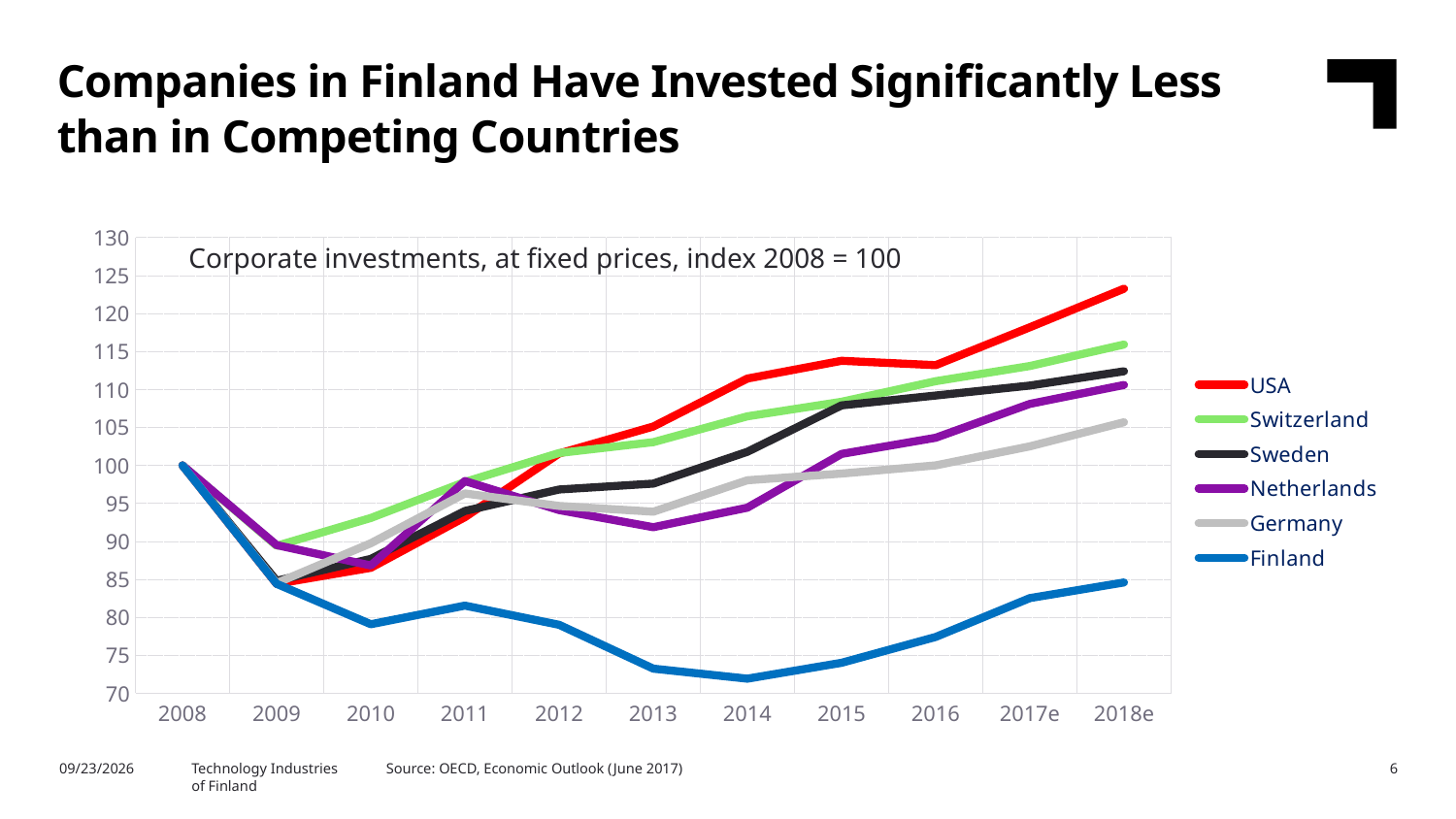
What is the subtitle printed inside the chart area? Corporate investments, at fixed prices, index 2008 = 100 What is the index value for all countries in 2008? 100 How many years are shown along the x axis? 11 How many series does the legend list? 6 Which is larger in 2018e, the value for USA or the value for Finland? USA Is the value for Sweden in 2018e greater or less than 110? greater Does the Finland line rise or fall from 2014 to 2018e? Rises Is the value for Finland in 2014 greater or less than 75? less Which country has the highest index value in 2018e? USA Is the value for USA in 2018e greater or less than 120? greater What kind of chart is shown on the slide? Line chart Which country has the lowest index value in 2018e? Finland